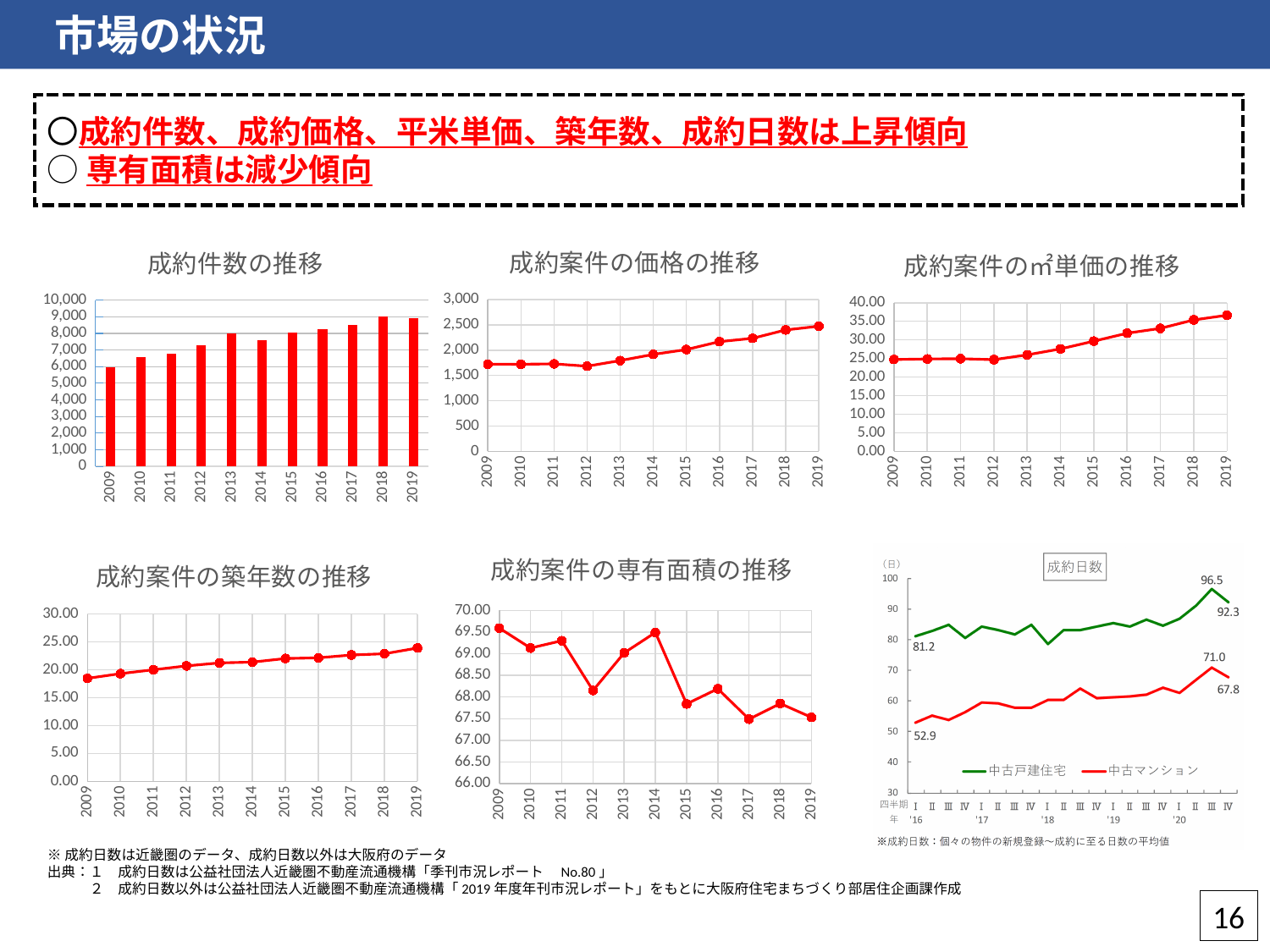
In the 成約案件の㎡単価の推移 chart, do the values generally rise or fall from 2009 to 2019? rise In the 成約件数の推移 chart, which year has the lowest value? 2009 In the 成約日数 chart, what is the difference between the two last labelled values of the 中古戸建住宅 series, 96.5 and 92.3? 4.2 In the 成約案件の専有面積の推移 chart, do the values generally rise or fall from 2009 to 2019? fall What kind of chart is the 成約件数の推移 chart? bar chart In the 成約日数 chart, which is larger: the 中古戸建住宅 peak of 96.5 or the 中古マンション peak of 71.0? 中古戸建住宅 (96.5) In the 成約日数 chart, what is the first labelled value of the 中古マンション series? 52.9 In the 成約案件の価格の推移 chart, is the value for 2019 greater or less than 2,000? greater In the 成約案件の築年数の推移 chart, is the value for 2009 greater or less than 20.00? less How many years are plotted in the 成約案件の価格の推移 chart? 11 In the 成約件数の推移 chart, is the value for 2012 greater or less than 7,000? greater In the 成約日数 chart, how many series does the legend list? 2